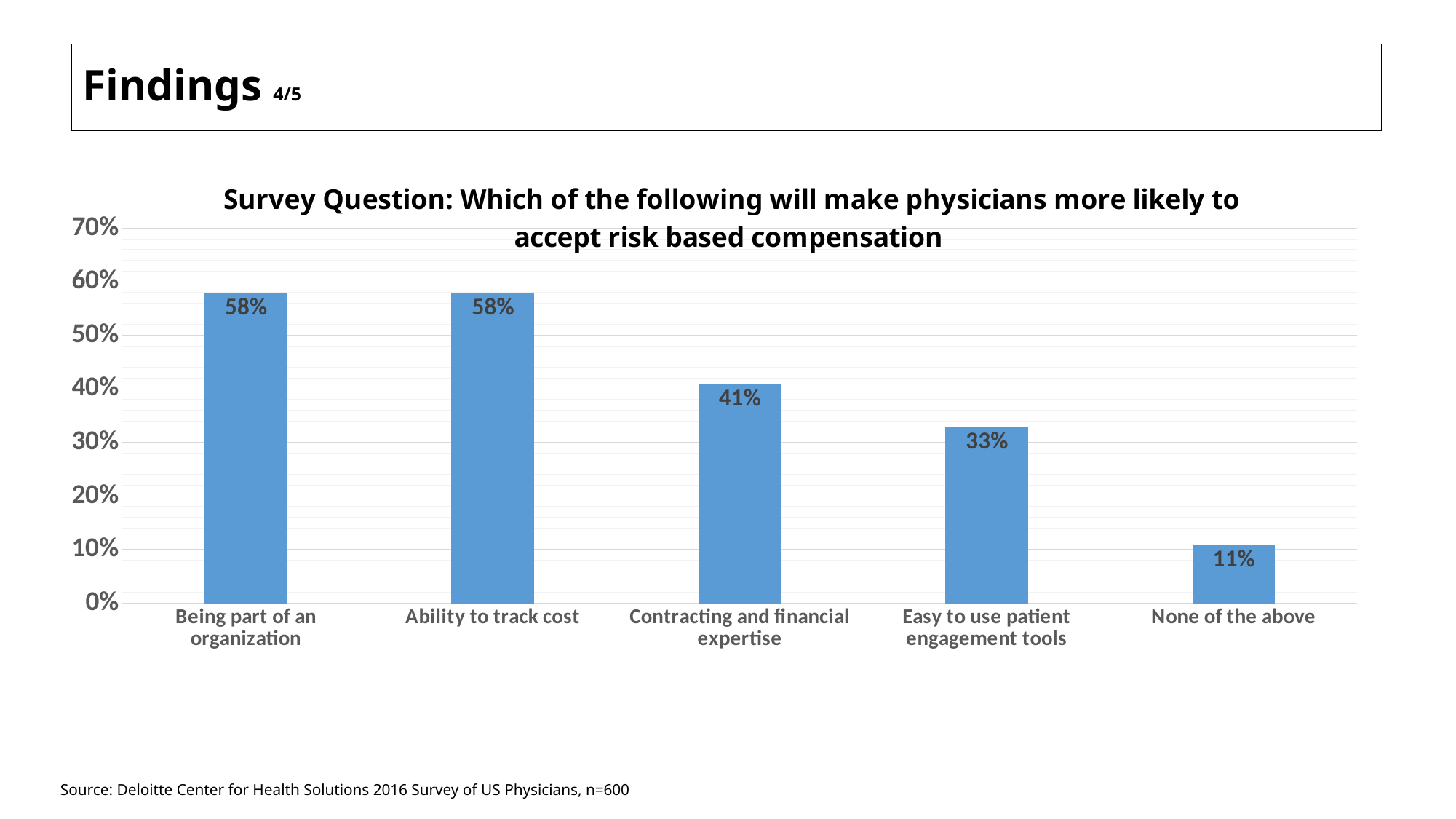
What is the value for "Easy to use patient engagement tools"? 33% What is the difference between "Contracting and financial expertise" and "Easy to use patient engagement tools"? 8% How many categories are shown on the chart? 5 Is the value for "Ability to track cost" greater or less than 50%? greater What is the value for "Ability to track cost"? 58% What percentage of physicians chose "Contracting and financial expertise"? 41% Which category has the lowest value? None of the above Which is larger: the value for "Contracting and financial expertise" or "Easy to use patient engagement tools"? Contracting and financial expertise What is the difference between the values for "Being part of an organization" and "None of the above"? 47% What is the value for "None of the above"? 11% What kind of chart is shown on the slide? Bar chart What is the highest value shown on the vertical axis? 70%